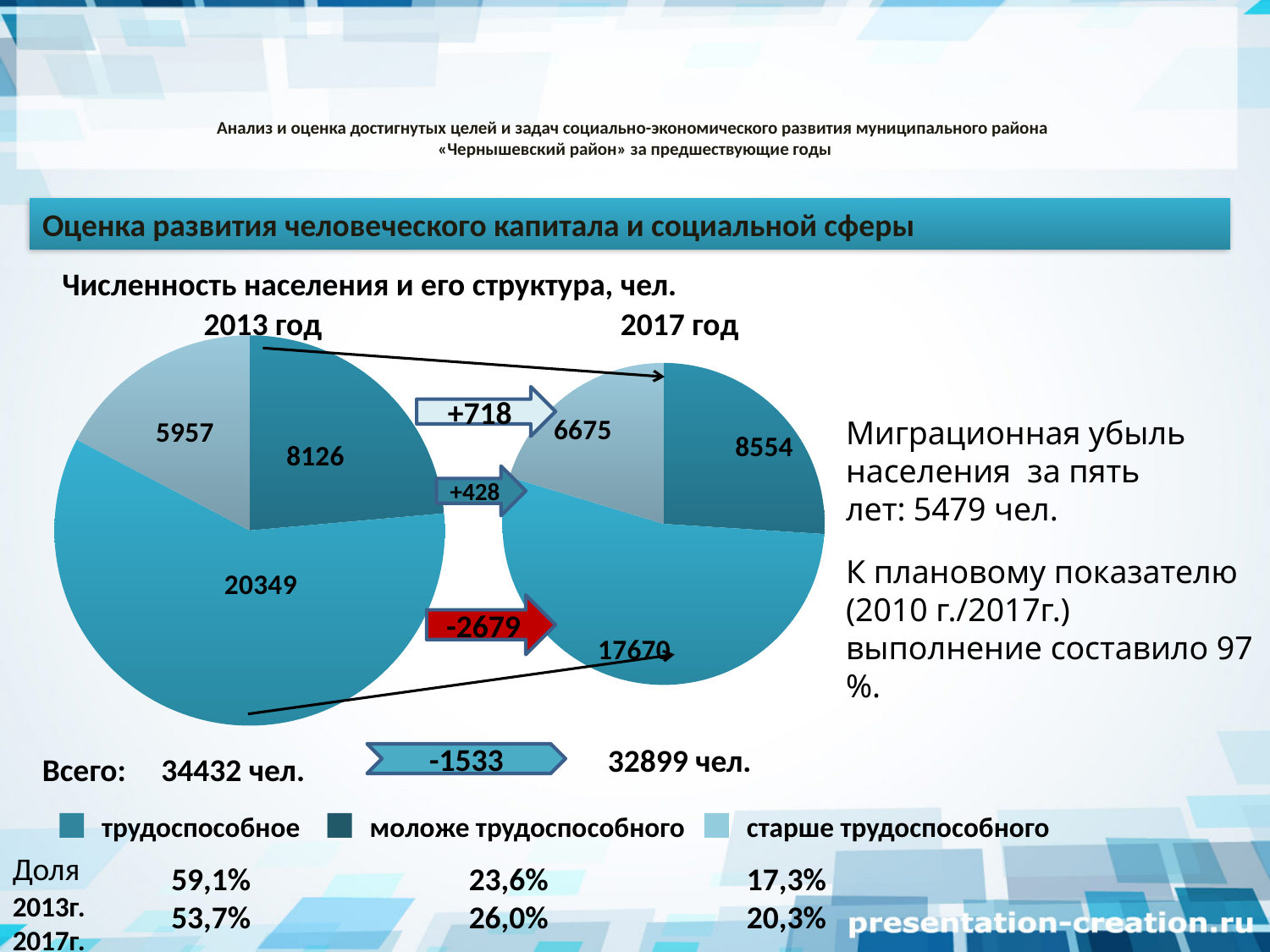
What type of charts are shown on the slide for 2013 год and 2017 год? Pie charts What is the total population (Всего) shown for 2017 год? 32899 чел. In the 2013 год pie chart, which category has the largest value? трудоспособное Which is larger: трудоспособное in 2013 год or трудоспособное in 2017 год? 2013 год What is the difference between трудоспособное and моложе трудоспособного in the 2013 год pie chart? 12223 In the 2017 год pie chart, what is the value for моложе трудоспособного? 8554 What is the difference between моложе трудоспособного and старше трудоспособного in the 2017 год pie chart? 1879 How many slices does each pie chart have? 3 What share of the 2013 год pie does трудоспособное represent, according to the Доля row? 59,1% In the 2013 год pie chart, what is the value for старше трудоспособного? 5957 In the 2017 год pie chart, which category has the smallest value? старше трудоспособного In the 2013 год pie chart, what is the value for трудоспособное? 20349